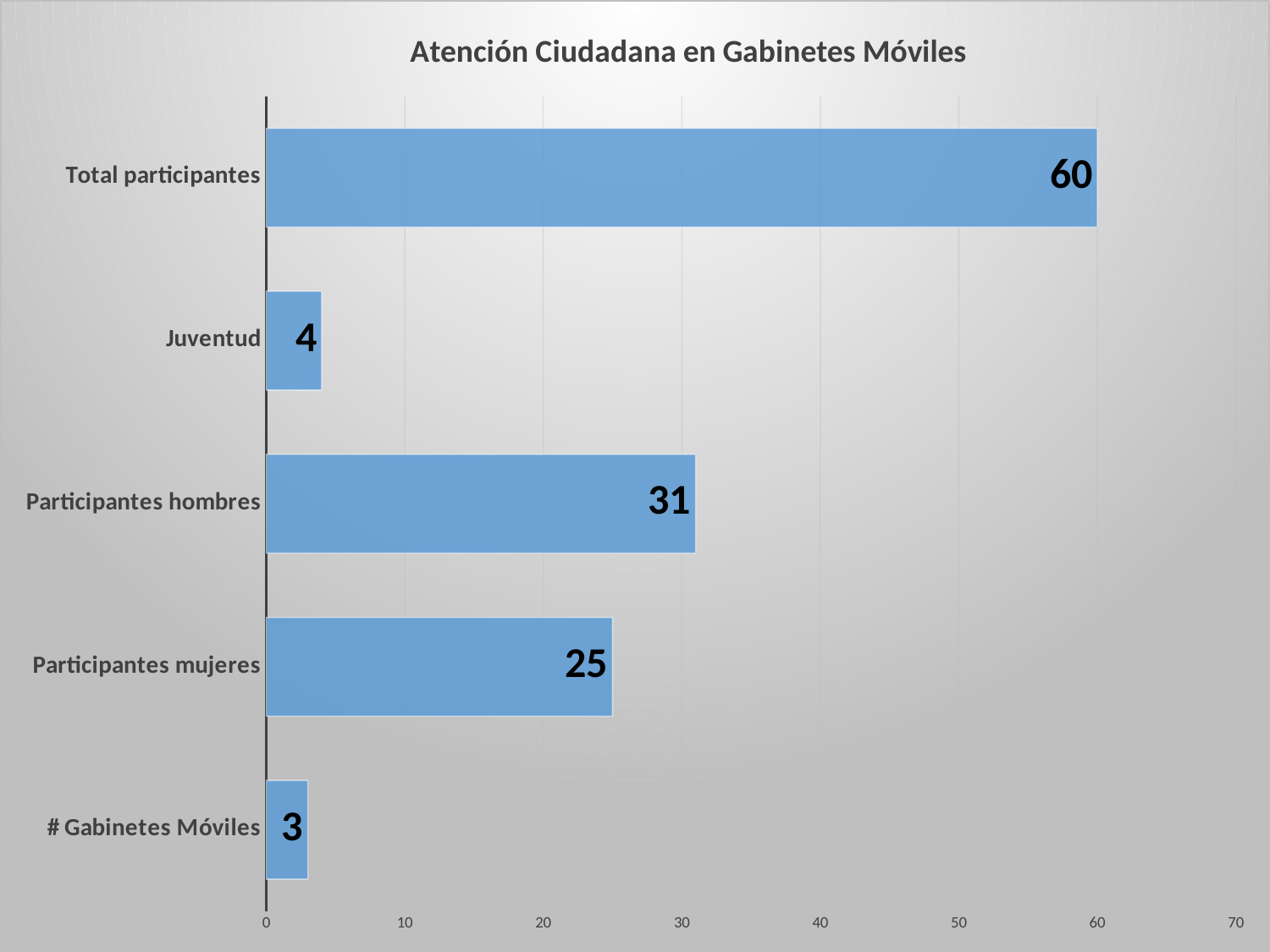
What is the value for Participantes mujeres? 25 What is the value for # Gabinetes Móviles? 3 Which is larger, Participantes hombres or Participantes mujeres? Participantes hombres What is the value for Total participantes? 60 What is the value for Juventud? 4 What kind of chart is this? Bar chart What is the value for Participantes hombres? 31 How many categories are shown in the chart? 5 Which category has the lowest value? # Gabinetes Móviles What is the difference between Participantes hombres and Participantes mujeres? 6 What is the title of the chart? Atención Ciudadana en Gabinetes Móviles Which category has the highest value? Total participantes